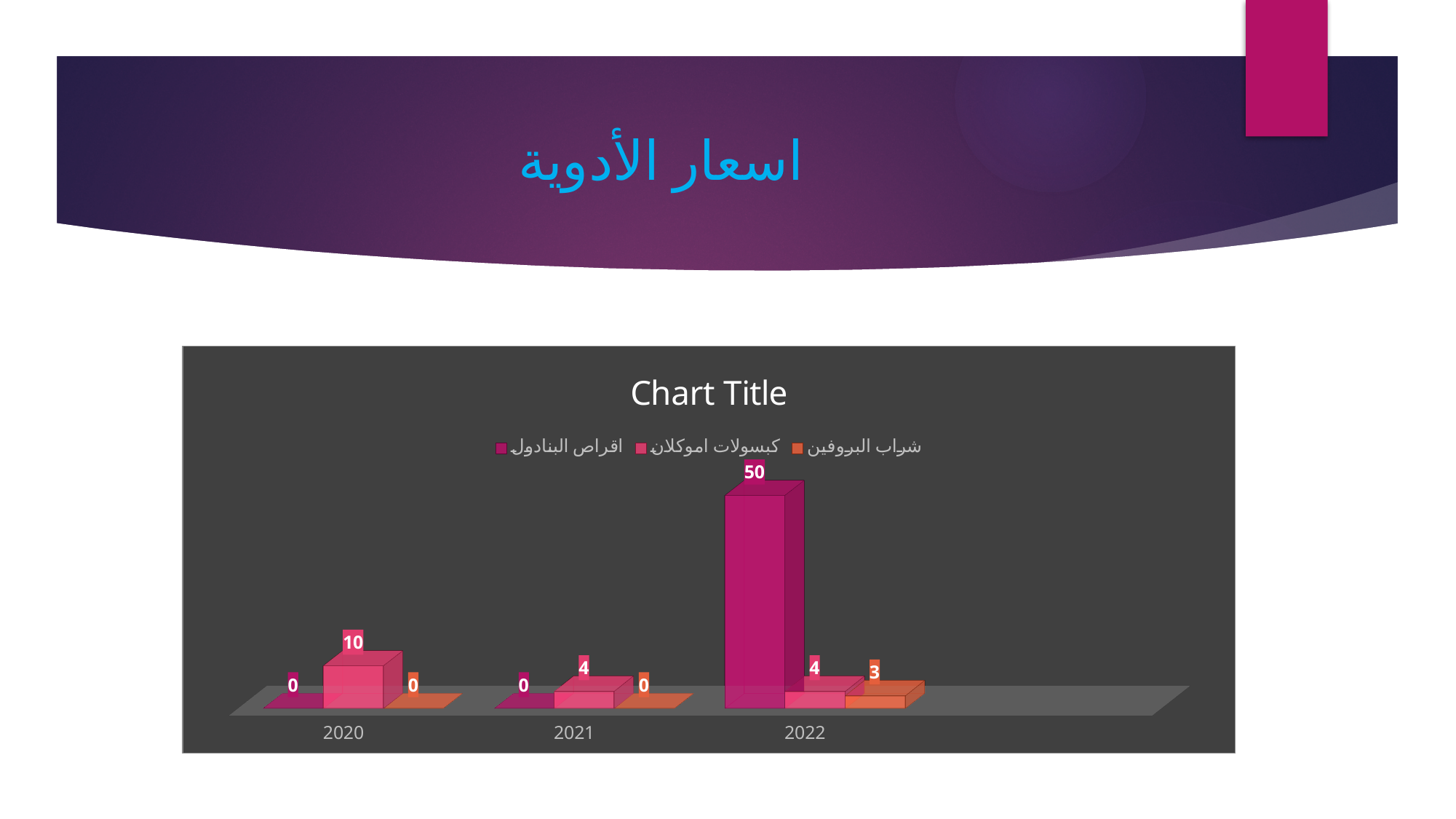
What is the value for كبسولات اموكلان in 2020? 10 What kind of chart is shown on the slide? Bar chart What is the value for كبسولات اموكلان in 2021? 4 What is the value for اقراص البنادول in 2022? 50 In which year is the value for اقراص البنادول highest? 2022 In which year is the value for كبسولات اموكلان highest? 2020 How many years are shown on the x axis? 3 Which is larger in 2020: the value for كبسولات اموكلان or the value for شراب البروفين? كبسولات اموكلان What is the title of the chart? Chart Title How many series does the legend list? 3 What is the value for شراب البروفين in 2022? 3 What is the difference between the value for اقراص البنادول and the value for كبسولات اموكلان in 2022? 46